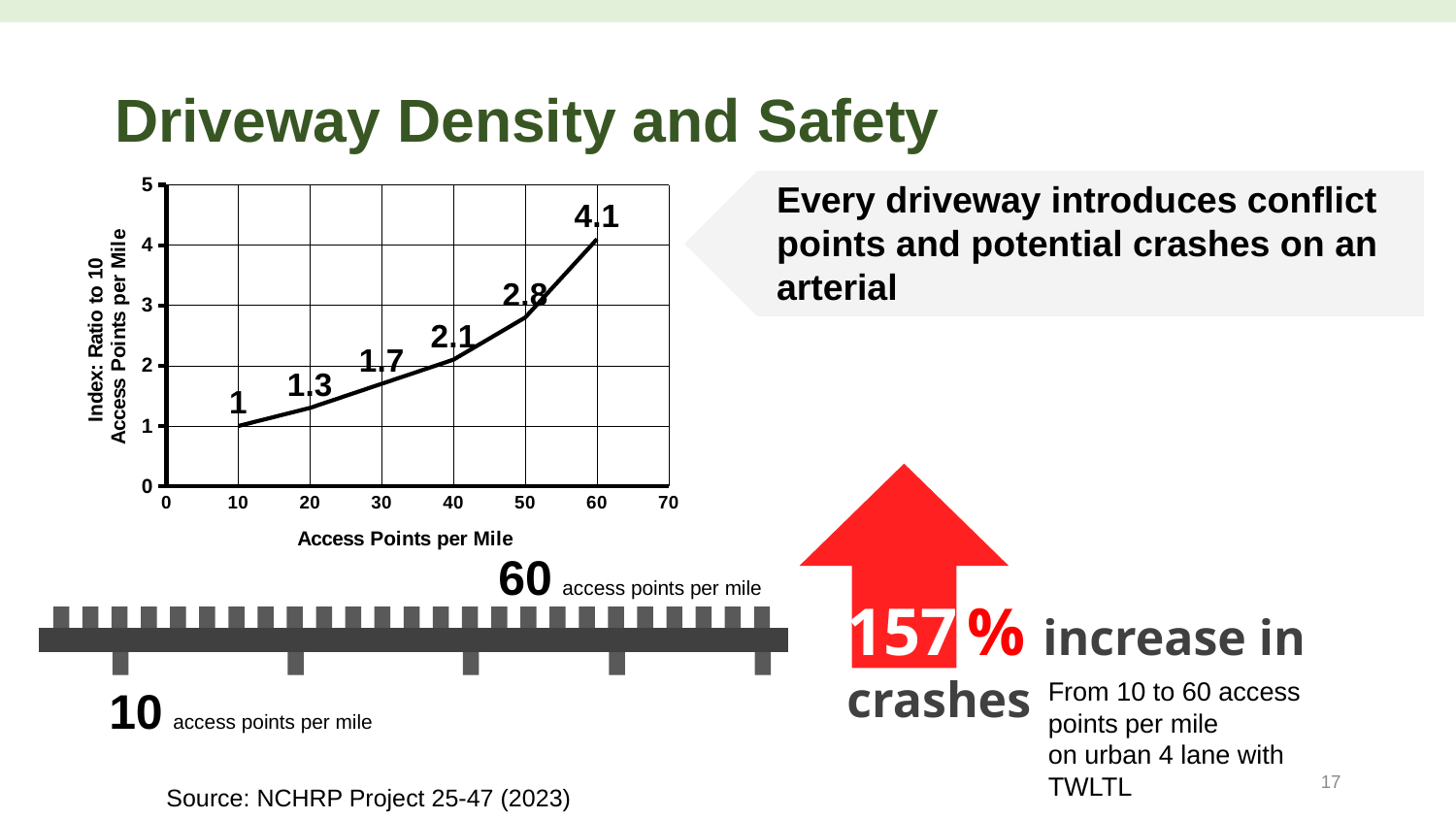
Which is larger, the index at 30 or the index at 20 access points per mile? 30 What is the index value at 50 access points per mile? 2.8 At which access points per mile value is the index highest? 60 At which access points per mile value is the index lowest? 10 How many labeled data points are plotted on the chart? 6 What is the label of the x axis of the chart? Access Points per Mile What is the index value at 10 access points per mile? 1 What is the difference between the index at 60 and the index at 10 access points per mile? 3.1 Does the index rise or fall as access points per mile increase? rise What is the index value at 60 access points per mile? 4.1 What kind of chart is shown on the slide? line chart What is the index value at 40 access points per mile? 2.1